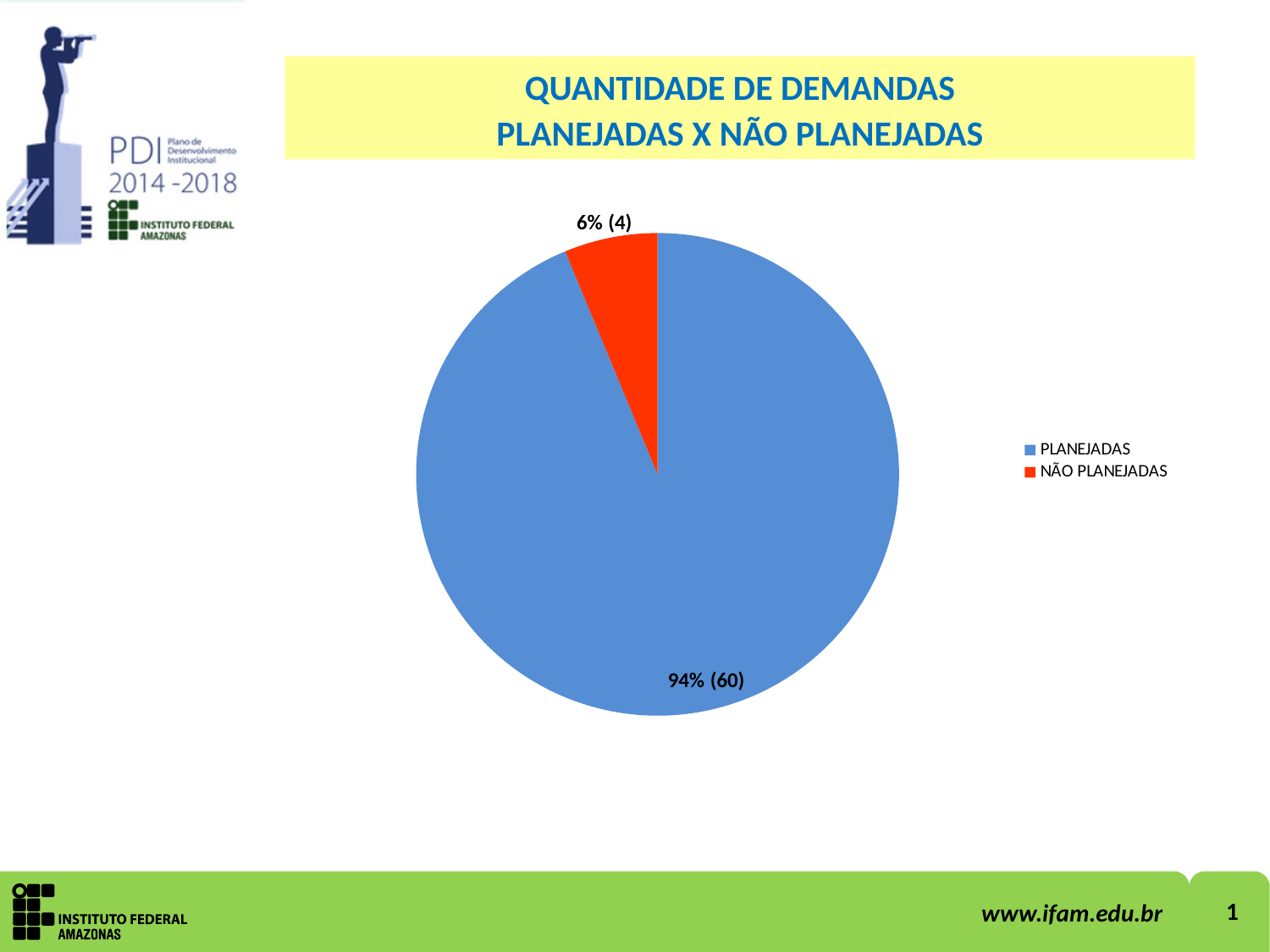
Which category has the largest slice of the pie? PLANEJADAS What is the difference in count between PLANEJADAS and NÃO PLANEJADAS demands? 56 What percentage of demands are NÃO PLANEJADAS? 6% What kind of chart is shown on the slide? pie chart How many demands are PLANEJADAS according to the data label? 60 What is the total number of demands shown in the pie chart? 64 What colour is the NÃO PLANEJADAS slice? red What percentage of demands are PLANEJADAS? 94% How many demands are NÃO PLANEJADAS according to the data label? 4 How many categories does the pie chart have? 2 Which category has the smallest slice of the pie? NÃO PLANEJADAS What is the title of the chart? QUANTIDADE DE DEMANDAS PLANEJADAS X NÃO PLANEJADAS